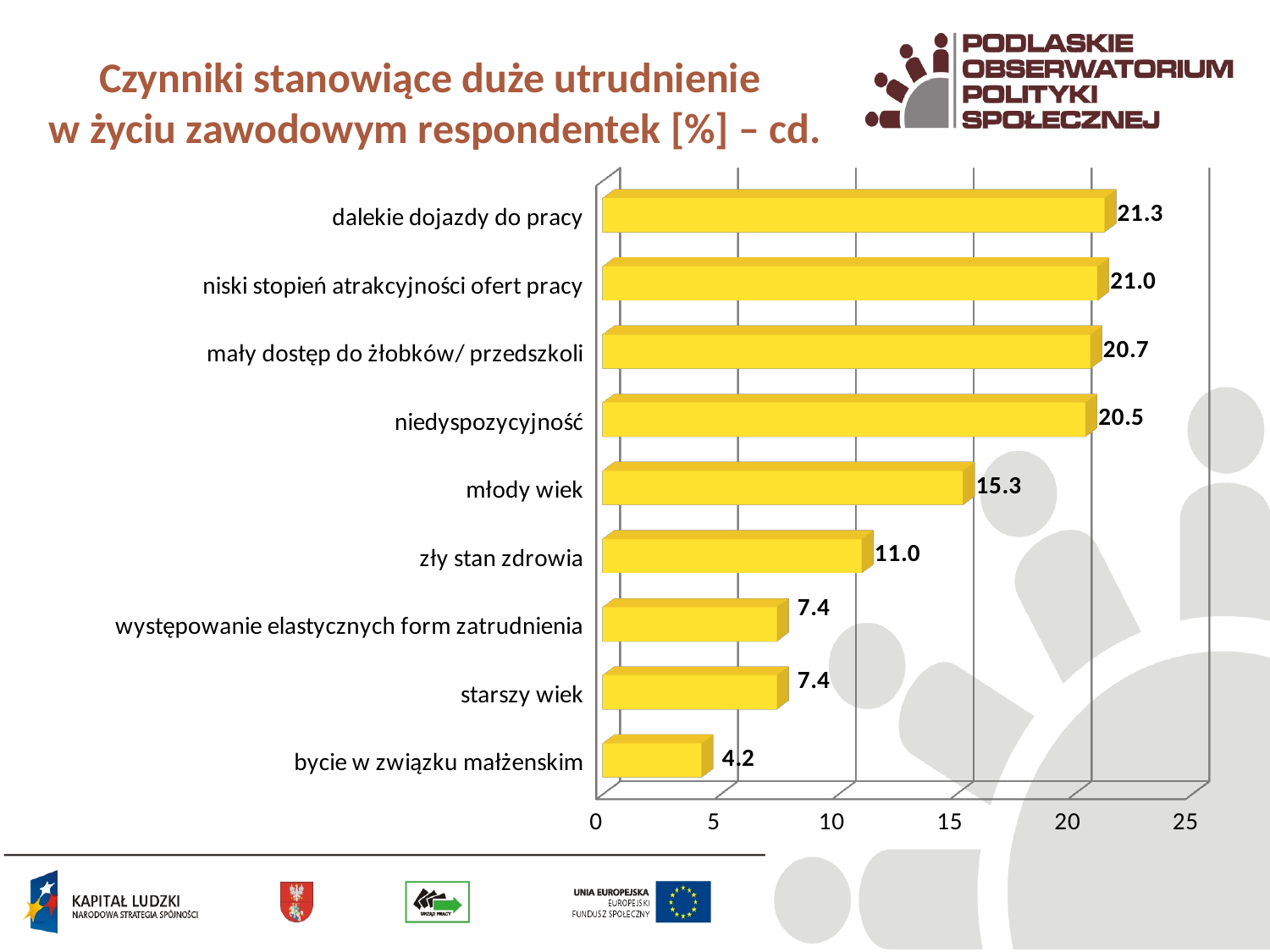
How many categories are shown in the chart? 9 What is the difference between the values for "dalekie dojazdy do pracy" and "bycie w związku małżenskim"? 17.1 What is the value for "młody wiek"? 15.3 What is the difference between the values for "młody wiek" and "zły stan zdrowia"? 4.3 Which category has the lowest value? bycie w związku małżenskim What is the maximum value shown on the horizontal axis? 25 Which category has the highest value? dalekie dojazdy do pracy Which is larger, the value for "niedyspozycyjność" or the value for "młody wiek"? niedyspozycyjność What is the value for "zły stan zdrowia"? 11.0 What is the value for "dalekie dojazdy do pracy"? 21.3 What is the value for "bycie w związku małżenskim"? 4.2 What kind of chart is shown on the slide? bar chart